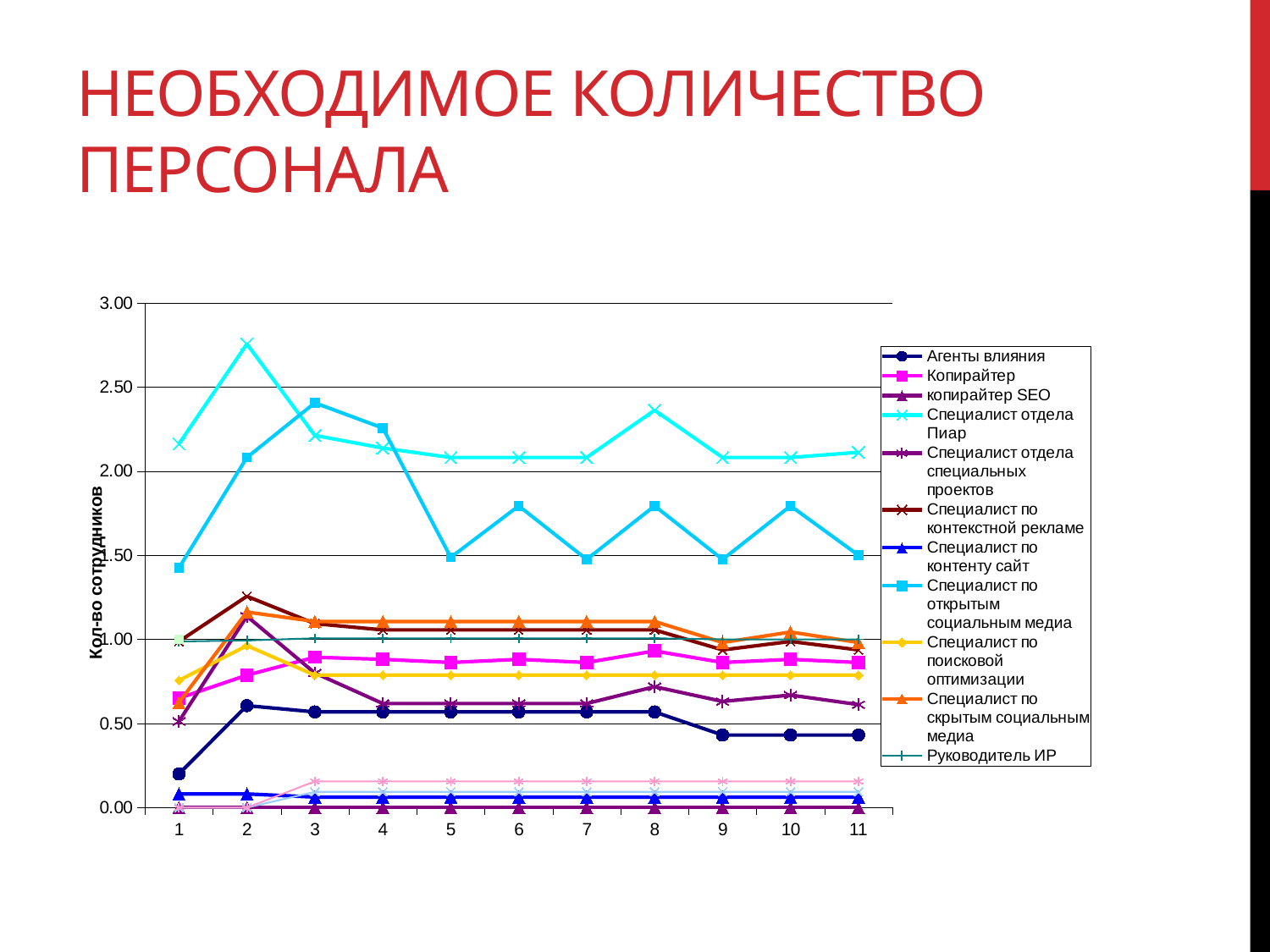
Does the value for Агенты влияния rise or fall from point 8 to point 9? fall Is the value for Специалист по открытым социальным медиа at point 3 greater or less than 2.00? greater Is the value for Специалист по контенту сайт at point 1 greater or less than 0.50? less What is the label of the y axis? Кол-во сотрудников At point 1, which is larger: Специалист отдела Пиар or Специалист по открытым социальным медиа? Специалист отдела Пиар At point 5, which is larger: Копирайтер or Агенты влияния? Копирайтер Is the value for Специалист отдела Пиар at point 2 greater or less than 2.50? greater How many series does the legend list? 11 How many points are there along the x axis? 11 What kind of chart is shown on the slide? line chart Which series has the highest value at point 2? Специалист отдела Пиар